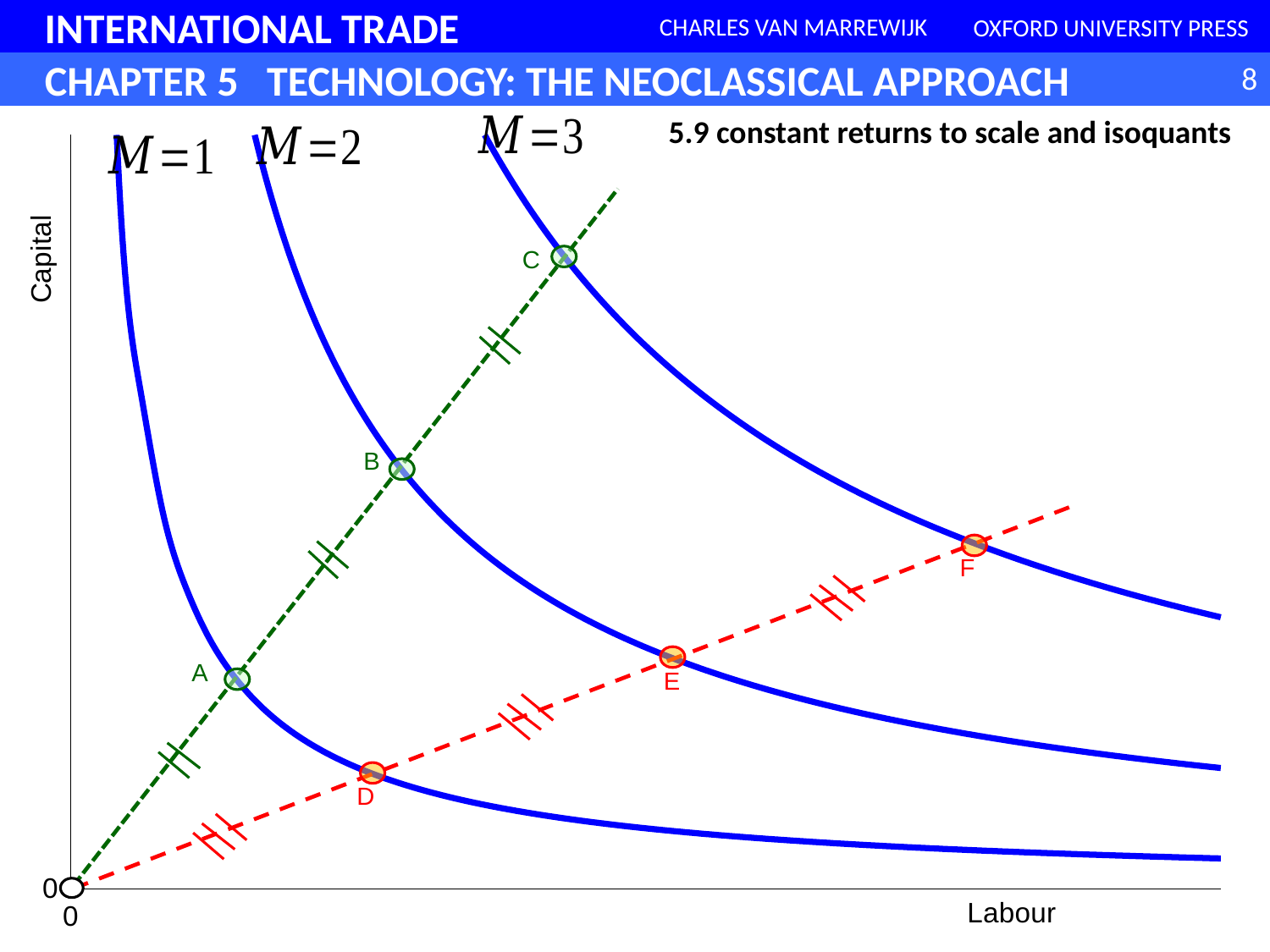
Which isoquant do points C and F lie on? M = 3 How many isoquant curves (M = 1, M = 2, M = 3) are drawn on the chart? 3 Moving along an isoquant from left to right, does the amount of capital rise or fall as labour increases? fall Which point uses more labour, point F or point D? F Which point lies at a higher level of capital, point C or point A? C What label is on the horizontal axis of the chart? Labour What is the title of the figure on the slide? 5.9 constant returns to scale and isoquants Which isoquant is farthest from the origin: M = 1, M = 2 or M = 3? M = 3 Which isoquant do points A and D lie on? M = 1 What label is on the vertical axis of the chart? Capital How many labelled points (A through F) are marked on the chart? 6 Which isoquant is closest to the origin: M = 1, M = 2 or M = 3? M = 1